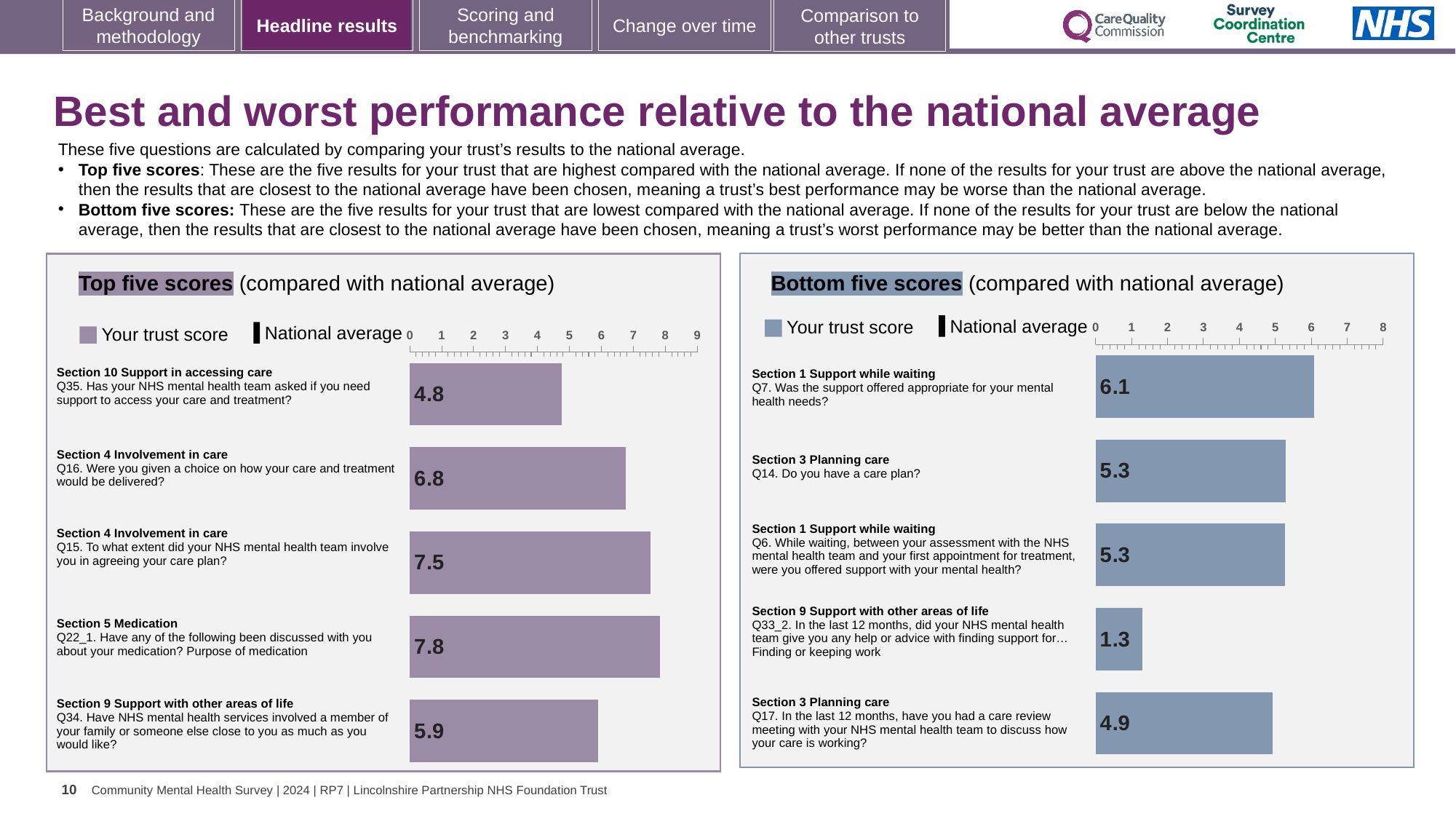
In the Bottom five scores chart, what is the trust score for Q7 (Was the support offered appropriate for your mental health needs?)? 6.1 In the Top five scores chart, is the trust score for Q15 greater or less than 7? greater In the Bottom five scores chart, what is the trust score for Q17 (care review meeting in the last 12 months)? 4.9 In the Bottom five scores chart, which has the larger trust score, Q7 or Q17? Q7 In the Top five scores chart, what is the trust score for Q16 (Were you given a choice on how your care and treatment would be delivered?)? 6.8 What type of chart is the Top five scores chart? Bar chart How many bars are shown in the Bottom five scores chart? 5 What two legend entries are shown above the Top five scores chart? Your trust score and National average In the Bottom five scores chart, which question has the lowest trust score? Q33_2 (Finding or keeping work), 1.3 In the Top five scores chart, which question has the lowest trust score? Q35, 4.8 In the Top five scores chart, which question has the highest trust score? Q22_1 (Purpose of medication), 7.8 In the Top five scores chart, what is the difference between the trust scores for Q22_1 and Q35? 3.0